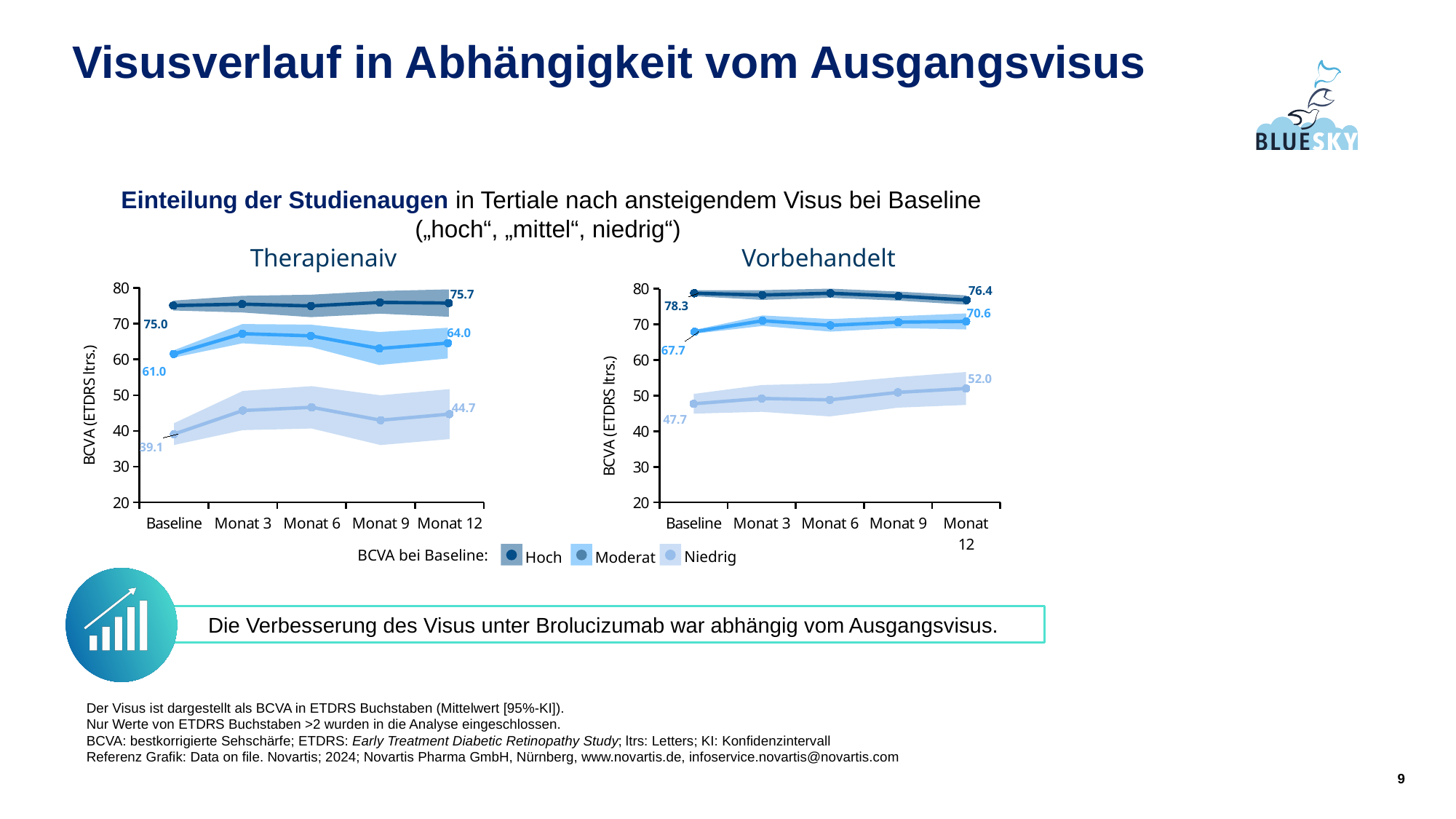
What kind of chart is the Therapienaiv chart? Line chart How many series does the legend list for the charts? 3 How many time points are shown on the x axis of the Vorbehandelt chart? 5 Which is larger: the Monat 12 Moderat value in the Therapienaiv chart or in the Vorbehandelt chart? Vorbehandelt In the Therapienaiv chart, what is the Monat 12 value for the Niedrig series? 44.7 In the Vorbehandelt chart, what is the Baseline value for the Moderat series? 67.7 In the Therapienaiv chart, is the Moderat value at Monat 3 greater or less than 60? greater In the Vorbehandelt chart, what is the difference between the Hoch and Niedrig values at Monat 12? 24.4 In the Vorbehandelt chart, what is the Monat 12 value for the Hoch series? 76.4 In the Vorbehandelt chart, does the Hoch series rise or fall from Baseline to Monat 12? Fall In the Therapienaiv chart, by how much did the Niedrig series change from Baseline (39.1) to Monat 12 (44.7)? 5.6 In the Therapienaiv chart, what is the Baseline value for the Hoch series? 75.0